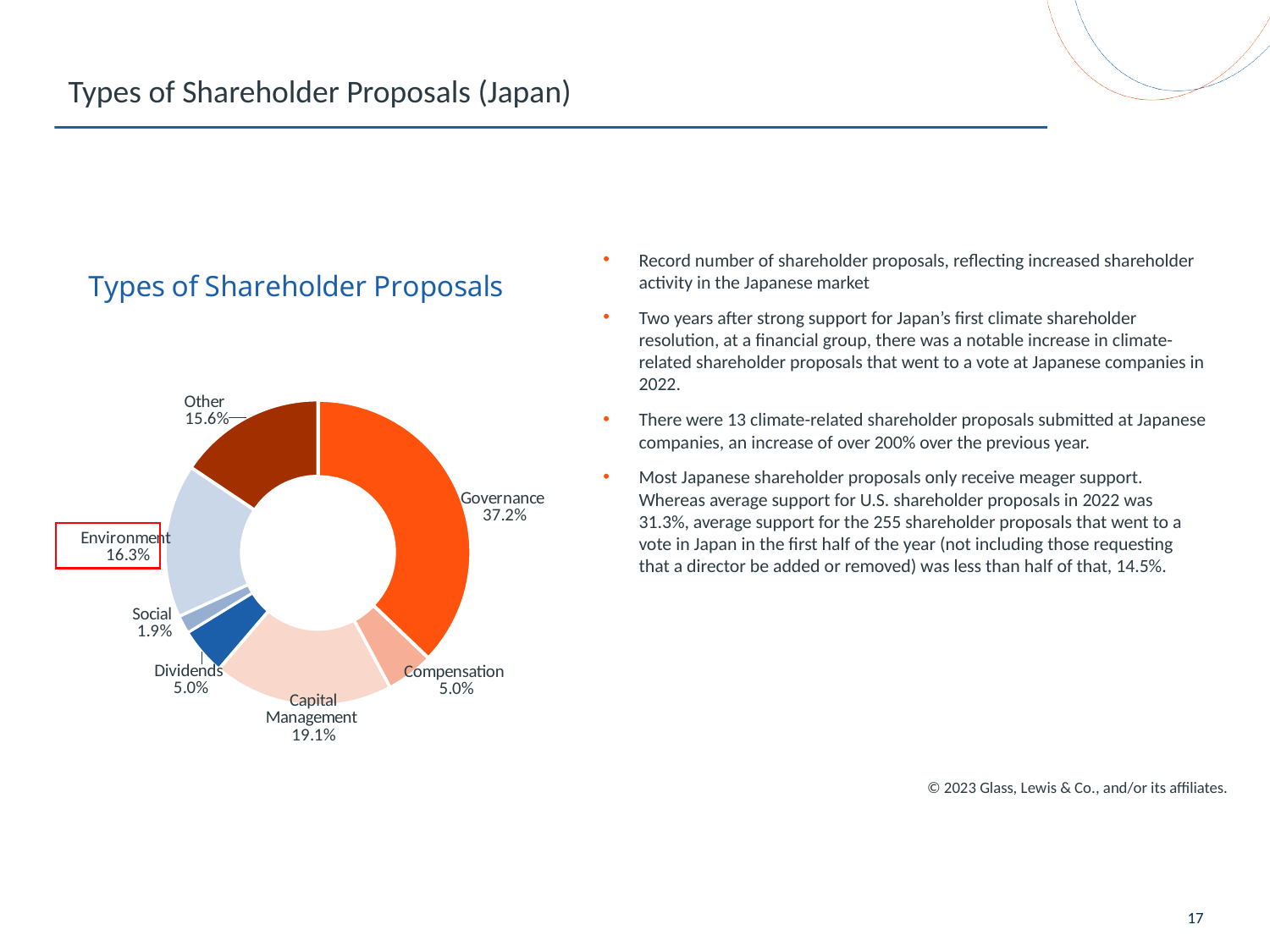
Which category has the largest share of shareholder proposals? Governance What is the title of the chart? Types of Shareholder Proposals What share of shareholder proposals is Environment? 16.3% Which category has the smallest share of shareholder proposals? Social What is the combined share of Dividends and Compensation? 10.0% How many categories are shown in the chart? 7 What share of shareholder proposals is Capital Management? 19.1% What share of shareholder proposals is Social? 1.9% Which is larger, the Environment share or the Other share? Environment What is the difference in percentage points between the Governance share and the Capital Management share? 18.1 What share of shareholder proposals is Governance? 37.2% What kind of chart is shown on the slide? Pie chart (doughnut)